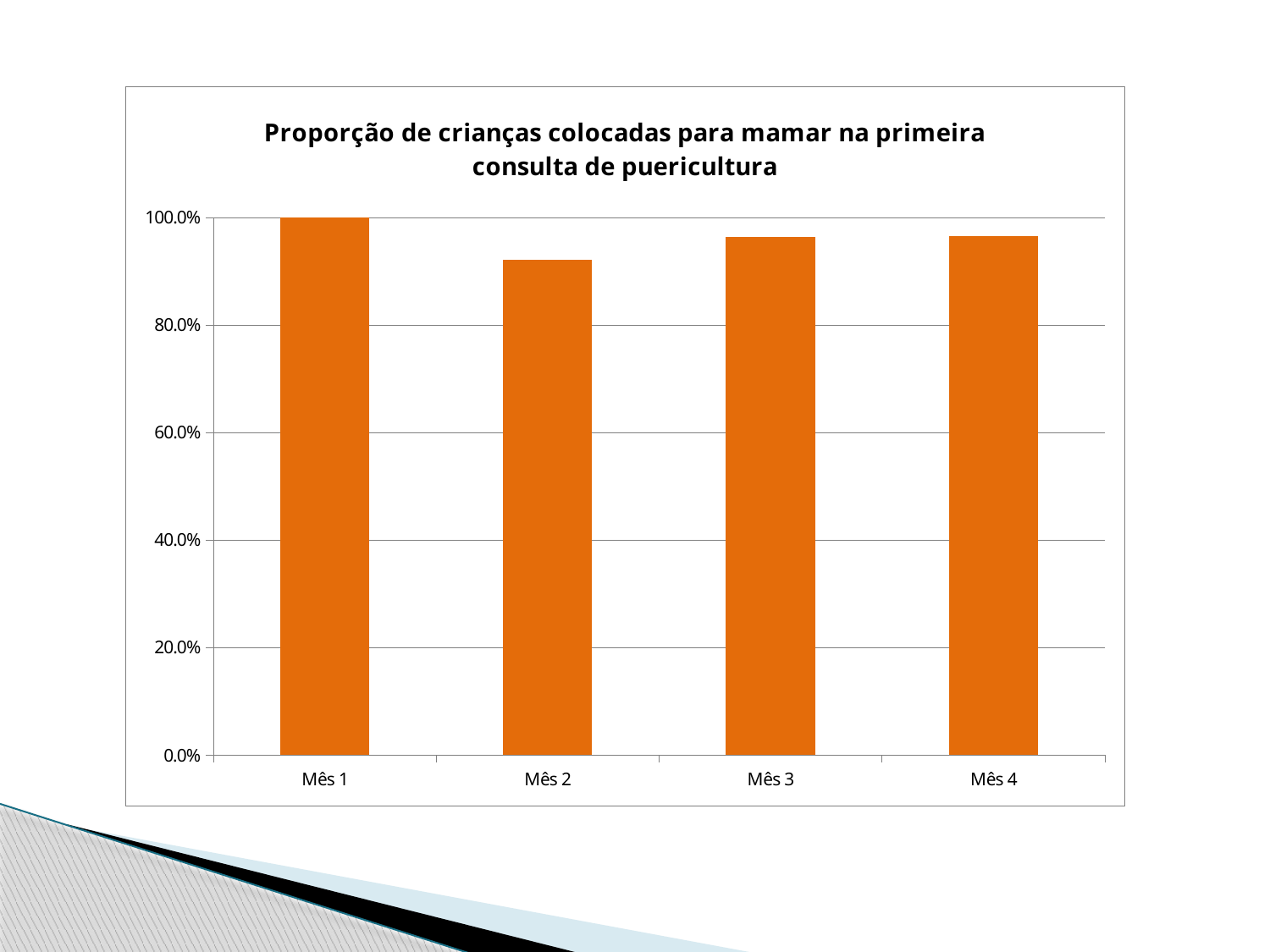
Is the value for Mês 2 greater or less than 80.0%? greater What is the title of the chart? Proporção de crianças colocadas para mamar na primeira consulta de puericultura What is the value for Mês 1? 100.0% Which month has the highest proportion? Mês 1 Which month has the lowest proportion? Mês 2 Which is larger, the value for Mês 1 or the value for Mês 2? Mês 1 Is the value for Mês 3 greater or less than 80.0%? greater Is the value for Mês 2 greater or less than 100.0%? less What kind of chart is shown on the slide? bar chart How many months (categories) are shown on the x axis? 4 What colour are the bars in the chart? orange Which is larger, the value for Mês 2 or the value for Mês 3? Mês 3